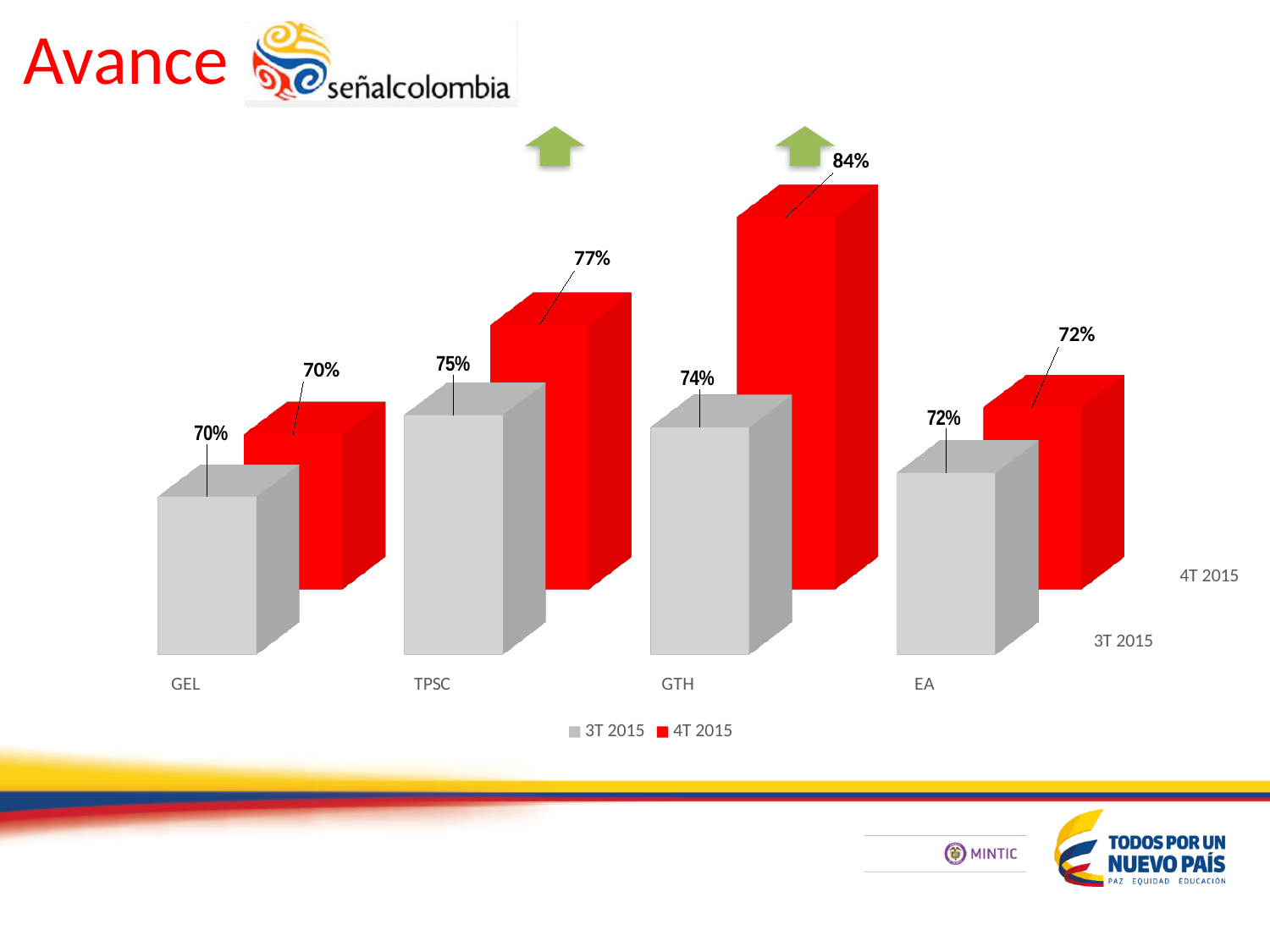
What is the difference between the 4T 2015 and 3T 2015 values for TPSC? 2% Which is larger for TPSC, the 3T 2015 value or the 4T 2015 value? 4T 2015 Which category has the lowest value in the 3T 2015 series? GEL How many categories are shown on the x axis? 4 What kind of chart is shown on the slide? Bar chart How many series does the legend list? 2 Which category has the highest value in the 4T 2015 series? GTH What is the value for TPSC in the 3T 2015 series? 75% What is the value for EA in the 4T 2015 series? 72% What is the difference between the 4T 2015 and 3T 2015 values for GTH? 10% What is the value for GEL in the 3T 2015 series? 70% What is the value for GTH in the 4T 2015 series? 84%